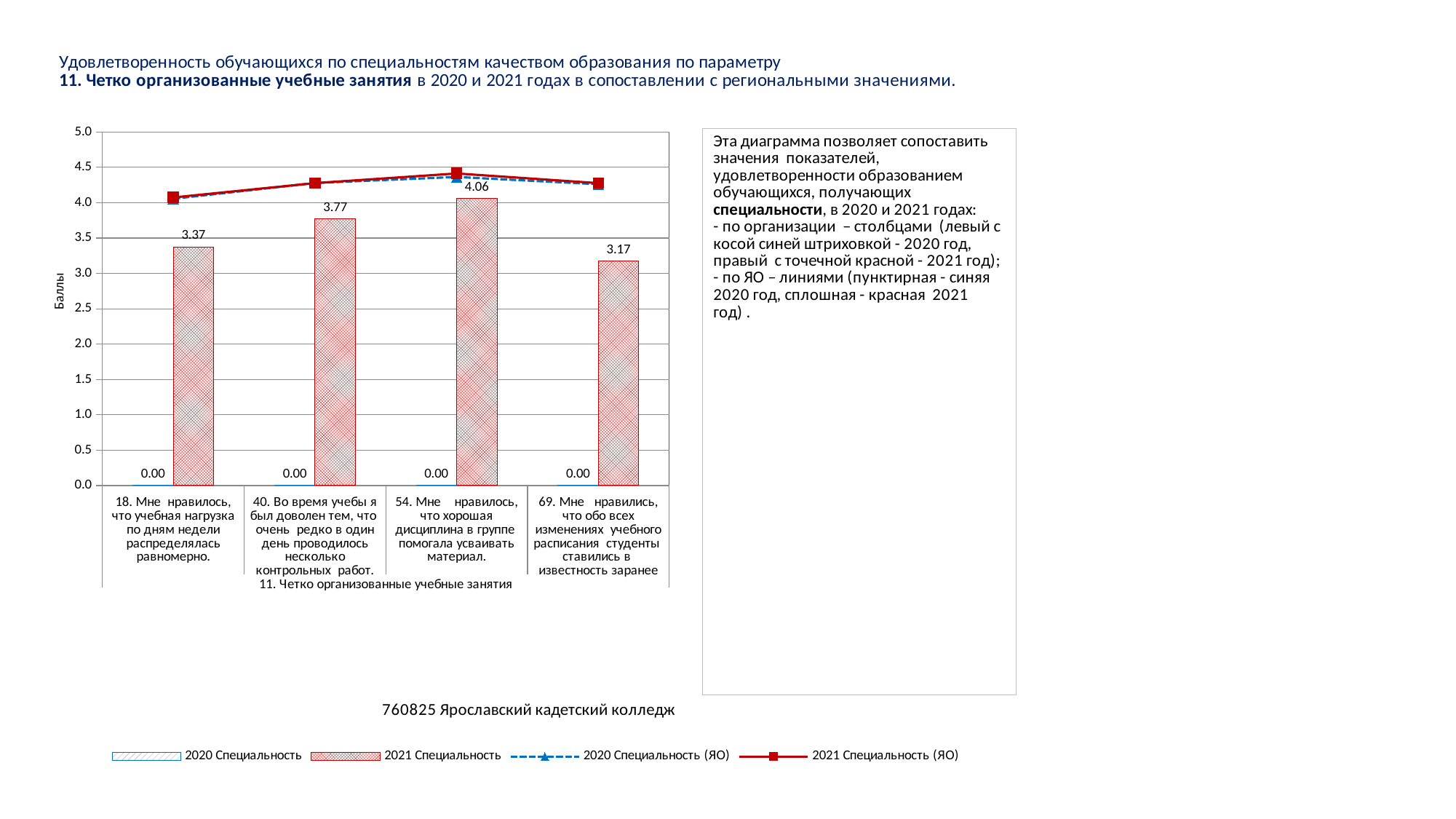
What is the 2021 Специальность value for question 18 (Мне нравилось, что учебная нагрузка по дням недели распределялась равномерно)? 3.37 Which is larger: the 2021 Специальность value for question 40 or for question 18? Question 40 (3.77) What is the label of the y axis? Баллы What type of chart is used for the Специальность values by organisation? Bar chart (combined with line series) How many questions (categories) are shown on the x axis? 4 How many series does the legend list? 4 Which question has the lowest 2021 Специальность value? 69. Мне нравились, что обо всех изменениях учебного расписания студенты ставились в известность заранее What is the 2021 Специальность value for question 54 (Мне нравилось, что хорошая дисциплина в группе помогала усваивать материал)? 4.06 Which question has the highest 2021 Специальность value? 54. Мне нравилось, что хорошая дисциплина в группе помогала усваивать материал. What is the 2020 Специальность value for question 40? 0.00 Is the 2021 Специальность (ЯО) line value for question 54 greater or less than 4.0? greater What is the difference between the 2021 Специальность values for question 54 and question 69? 0.89